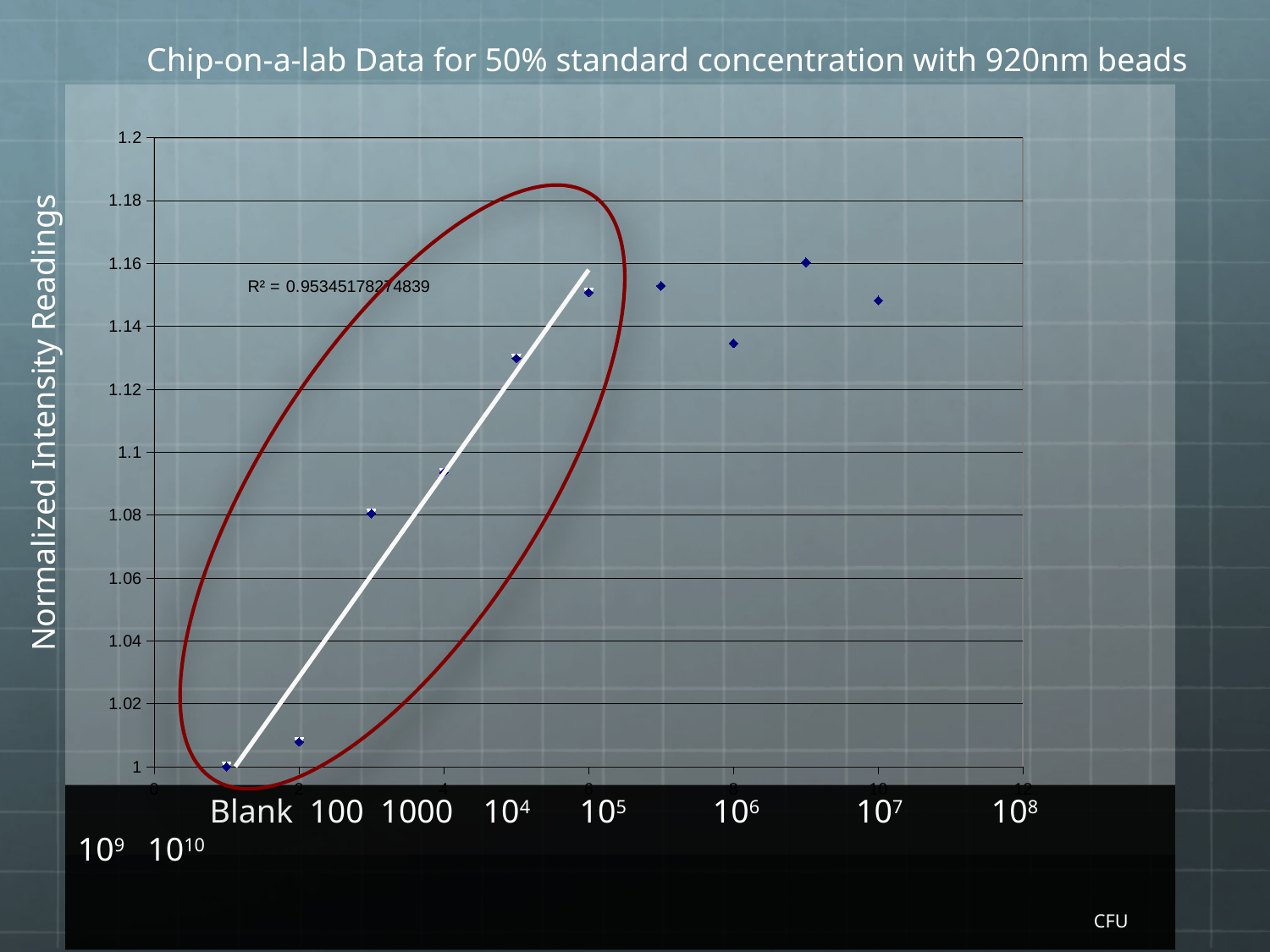
Is the highest plotted value on the chart greater or less than 1.14? greater Which is larger, the value of the second point from the left or the value of the third point from the left? the third point from the left What is the title of the chart? Chip-on-a-lab Data for 50% standard concentration with 920nm beads Which plotted point has the lowest normalized intensity reading? the leftmost point (Blank) Is the value of the leftmost plotted point (Blank) greater or less than 1.02? less Is the value of the rightmost plotted point greater or less than 1.16? less What kind of chart is shown on the slide? scatter chart Do the normalized intensity readings generally rise or fall from left to right along the x axis? rise How many data points are plotted on the chart? 10 What R² value is printed on the chart? R² = 0.95345178274839 Which is larger, the value of the leftmost plotted point or the value of the rightmost plotted point? the rightmost point